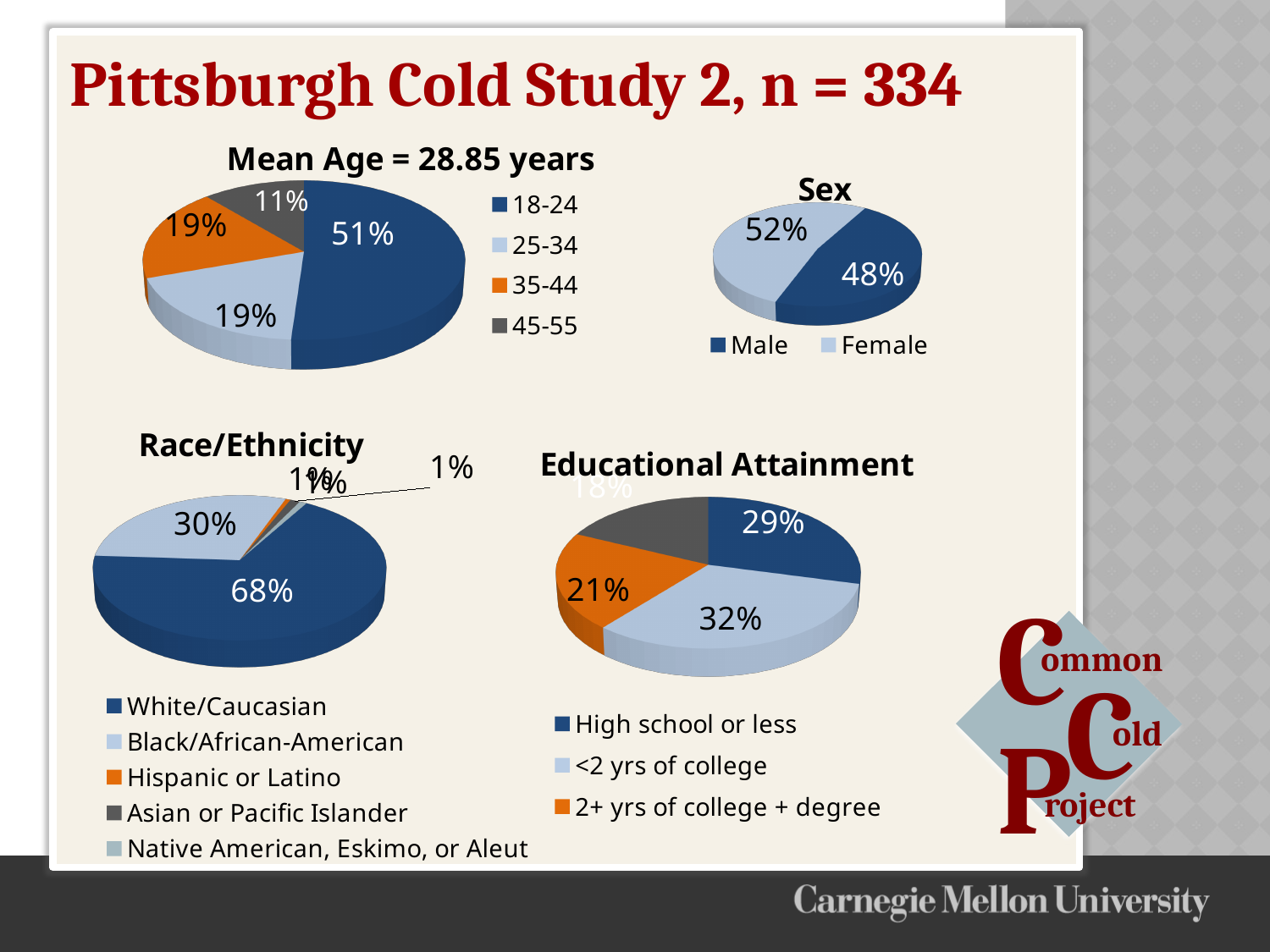
In the Mean Age chart, what share of participants are aged 18-24? 51% In the Mean Age chart, which age group has the smallest share? 45-55 In the Sex chart, what percentage of participants are Female? 52% In the Race/Ethnicity chart, what share of participants are Black/African-American? 30% How many categories does the legend of the Race/Ethnicity chart list? 5 In the Race/Ethnicity chart, what share of participants are White/Caucasian? 68% In the Sex chart, which is larger, the Male share or the Female share? Female In the Educational Attainment chart, what is the difference between the <2 yrs of college share and the 2+ yrs of college + degree share? 11% How many age groups does the legend of the Mean Age chart list? 4 What type of chart is used for the Sex data on the slide? Pie chart In the Educational Attainment chart, what share of participants have <2 yrs of college? 32% In the Mean Age chart, what is the difference between the 18-24 share and the 45-55 share? 40%